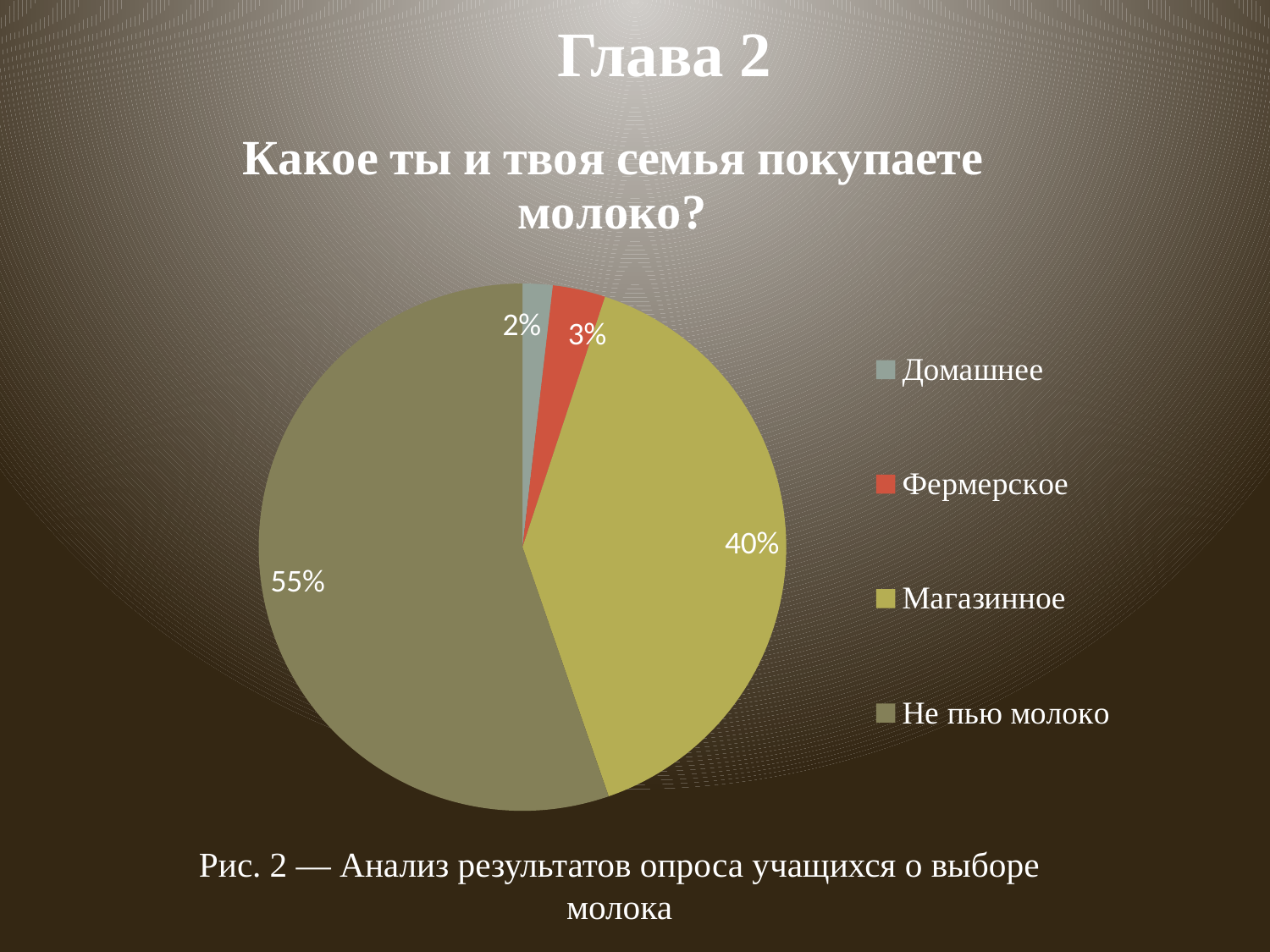
Which is larger, the share for "Фермерское" or the share for "Домашнее"? Фермерское What is the title of the chart? Какое ты и твоя семья покупаете молоко? What is the value shown for "Домашнее"? 2% What is the difference between the shares of "Не пью молоко" and "Магазинное"? 15% Which category has the smallest slice of the pie? Домашнее What share of the pie does "Магазинное" take? 40% What is the value shown for "Фермерское"? 3% What kind of chart is shown on the slide? pie chart How many categories does the pie chart have? 4 Which category is shown in red in the legend? Фермерское What share of the pie does "Не пью молоко" take? 55% Which category has the largest slice of the pie? Не пью молоко